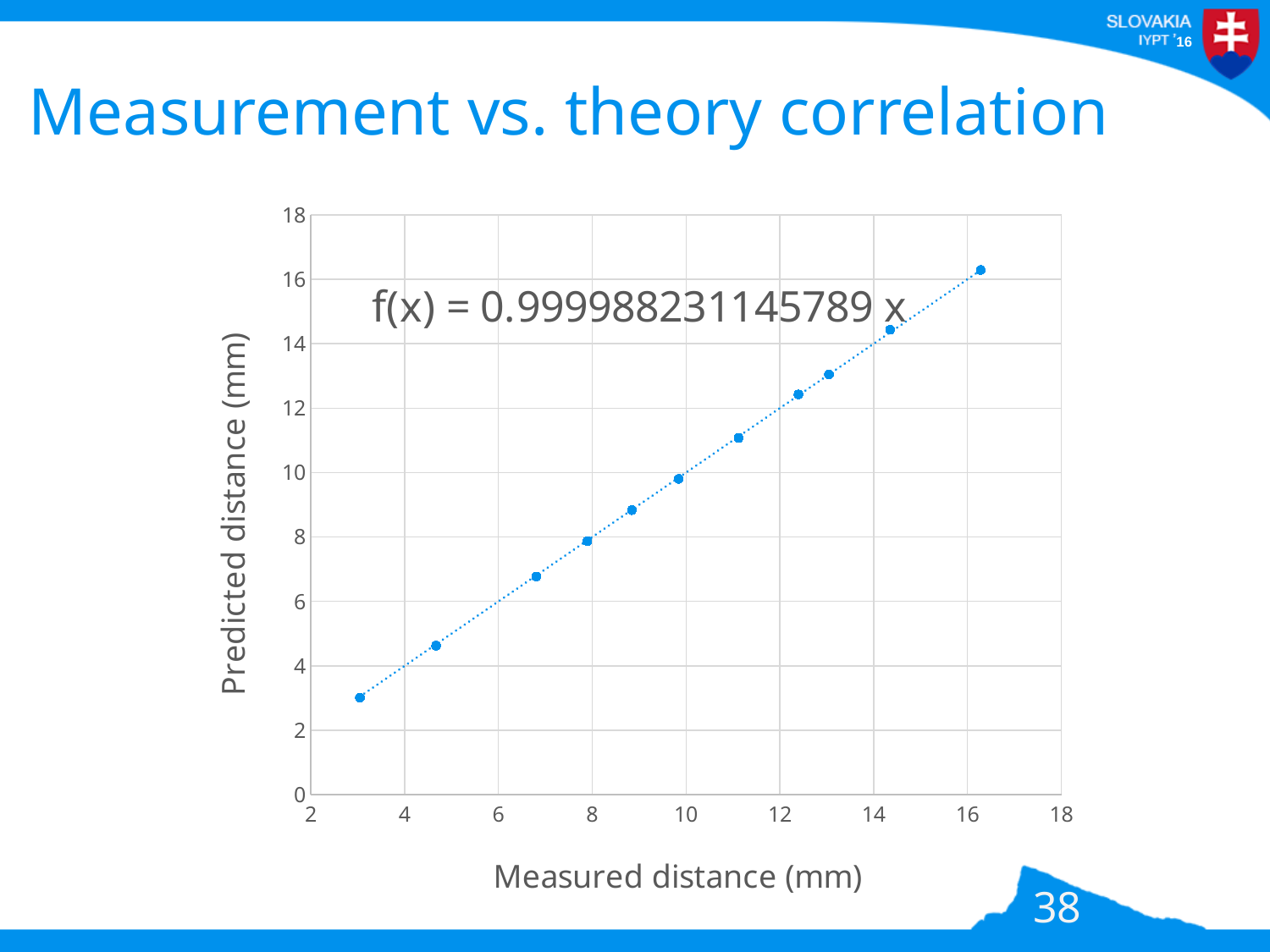
How many data points are plotted on the chart? 11 Do the plotted points rise or fall as measured distance increases along the x axis? Rise What kind of chart is shown on the slide? Scatter chart Is the predicted distance of the leftmost data point greater or less than 4 mm? less Is the predicted distance of the data point with a measured distance of about 11 mm greater or less than 10 mm? greater Which data point has the highest predicted distance: the leftmost or the rightmost point? The rightmost point Is the predicted distance of the data point with a measured distance of about 6.8 mm greater or less than 8 mm? less What fitted equation is printed on the chart? f(x) = 0.999988231145789 x What is the title of the chart's x axis? Measured distance (mm)